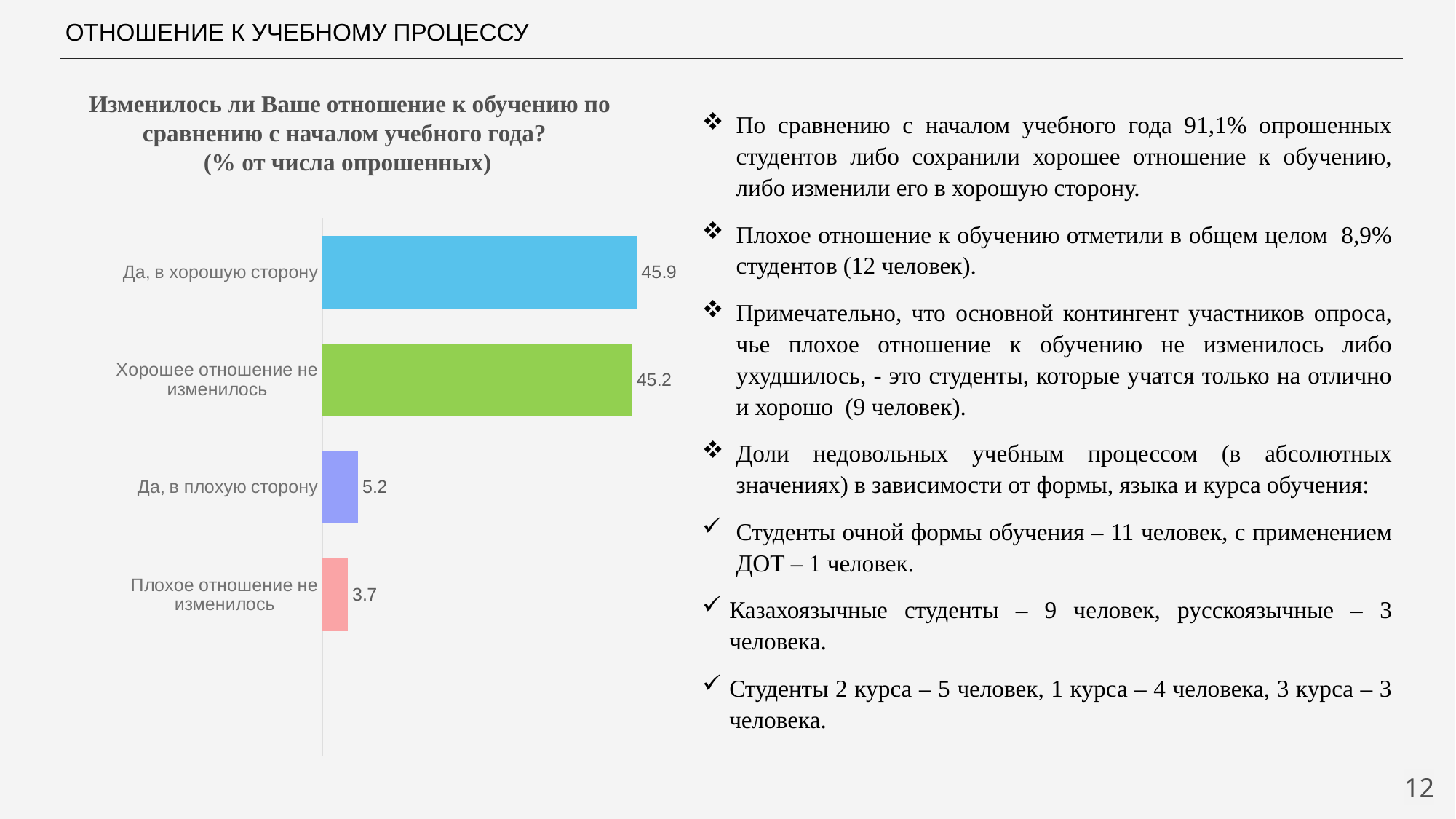
What is the value for "Да, в хорошую сторону"? 45.9 What kind of chart is shown on the slide? Bar chart What colour is the bar for "Хорошее отношение не изменилось"? Green What is the difference between the values for "Да, в хорошую сторону" and "Хорошее отношение не изменилось"? 0.7 How many categories are shown in the chart? 4 Which is larger: the value for "Да, в плохую сторону" or the value for "Плохое отношение не изменилось"? Да, в плохую сторону Which category has the highest value? Да, в хорошую сторону What is the value for "Плохое отношение не изменилось"? 3.7 What is the value for "Хорошее отношение не изменилось"? 45.2 Which category has the lowest value? Плохое отношение не изменилось What is the difference between the values for "Да, в плохую сторону" and "Плохое отношение не изменилось"? 1.5 What is the value for "Да, в плохую сторону"? 5.2